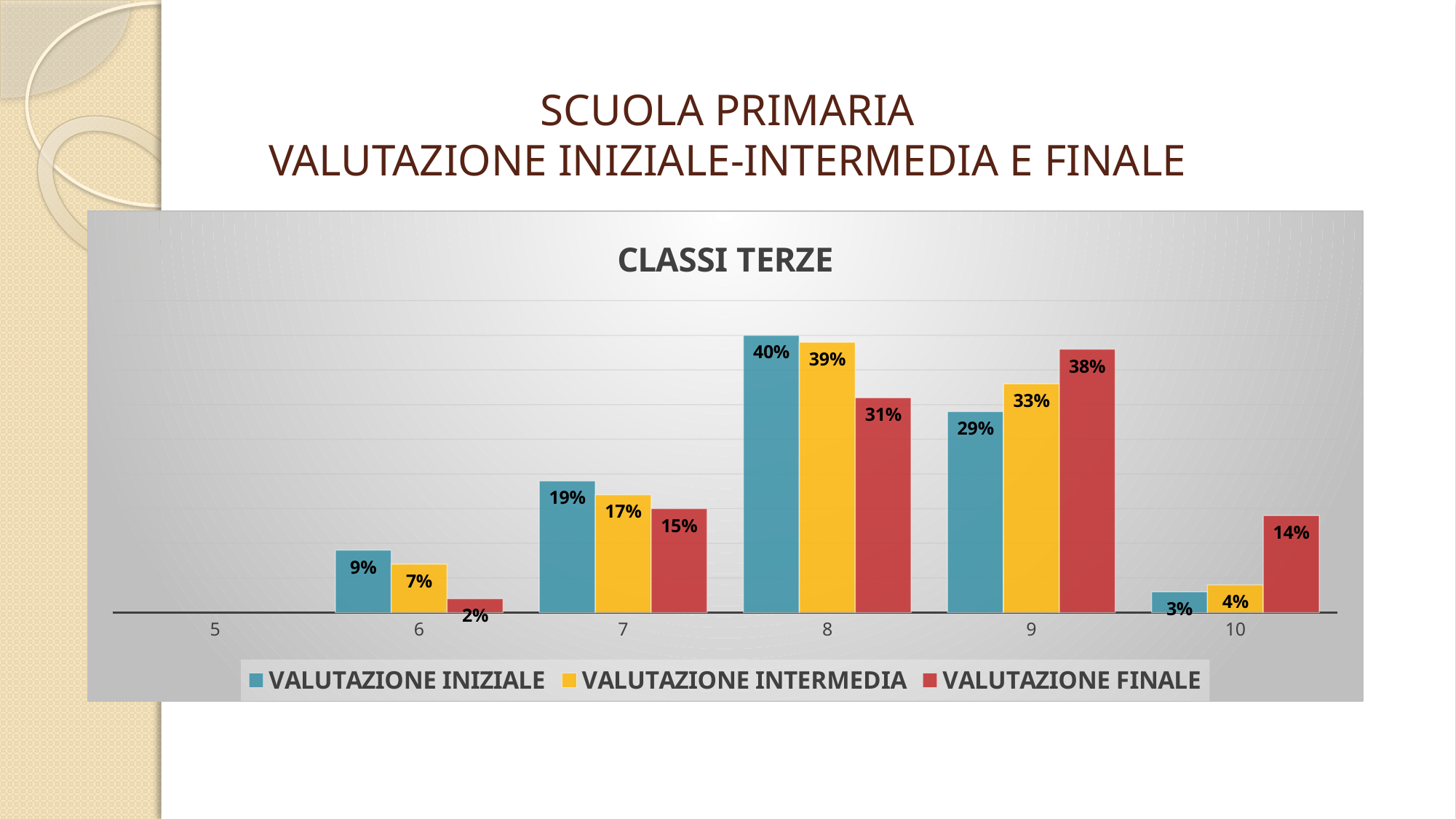
What is the VALUTAZIONE INTERMEDIA value for category 9? 33% What is the difference between the VALUTAZIONE INIZIALE and VALUTAZIONE FINALE values for category 8? 9% What is the VALUTAZIONE INIZIALE value for category 8? 40% What is the VALUTAZIONE FINALE value for category 10? 14% What kind of chart is shown on the slide? Bar chart What is the title of the chart? CLASSI TERZE How many categories are shown on the x axis? 6 For category 9, which is larger: VALUTAZIONE INIZIALE or VALUTAZIONE FINALE? VALUTAZIONE FINALE Which category has the highest VALUTAZIONE FINALE value? 9 What is the VALUTAZIONE FINALE value for category 6? 2% How many series does the legend list? 3